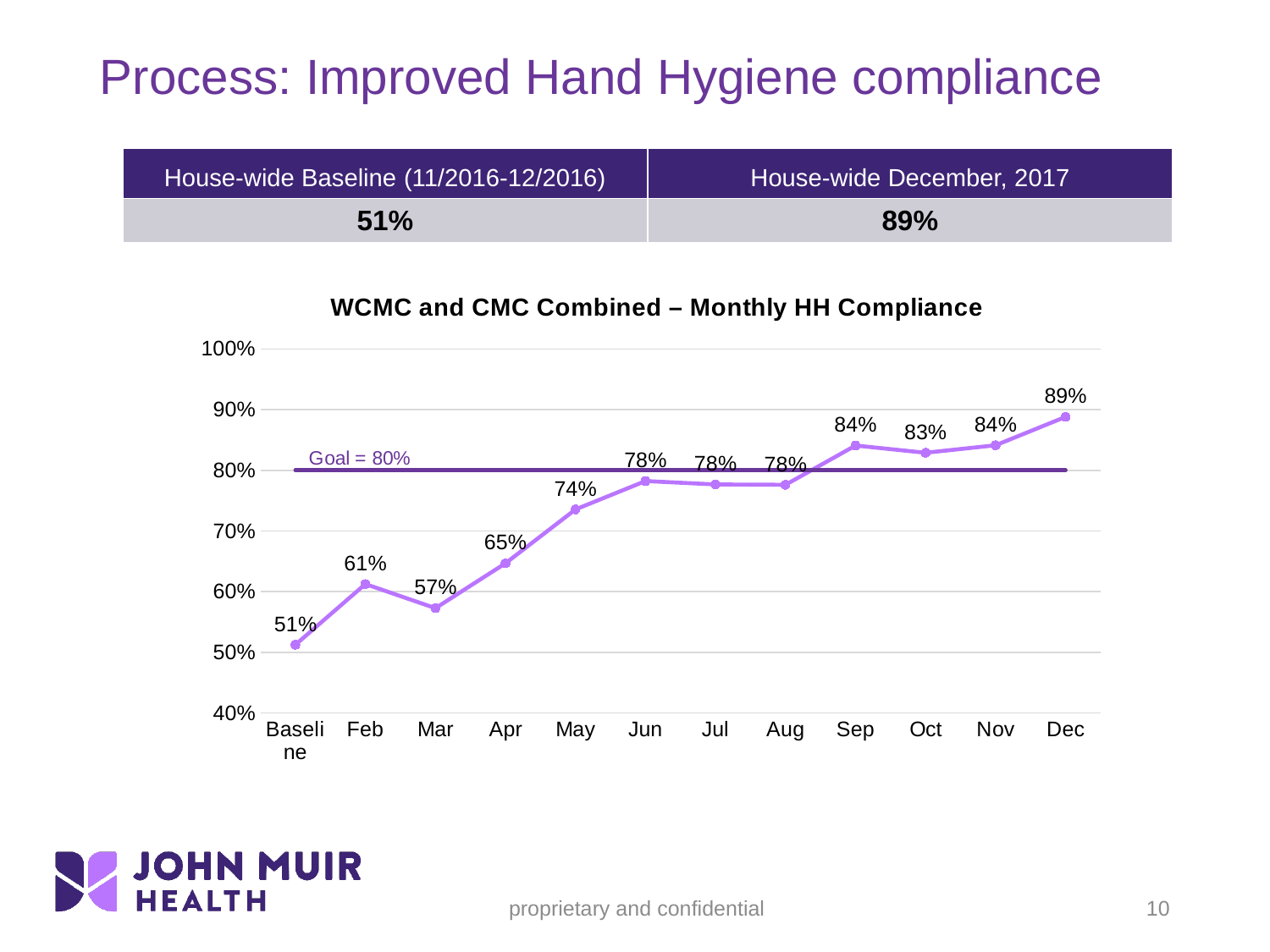
What is the HH compliance value for Mar? 57% How many data points are plotted on the line? 12 What kind of chart is shown on the slide? line chart What is the HH compliance value for Oct? 83% Which is larger, the value for Feb or the value for Mar? Feb Which category has the lowest HH compliance value? Baseline Is the value for Sep greater or less than 80%? greater What is the HH compliance value for Dec? 89% Which category has the highest HH compliance value? Dec What is the difference between the Dec value and the Baseline value? 38% What goal value is marked by the horizontal line on the chart? 80% Do the values generally rise or fall from Baseline to Dec? rise